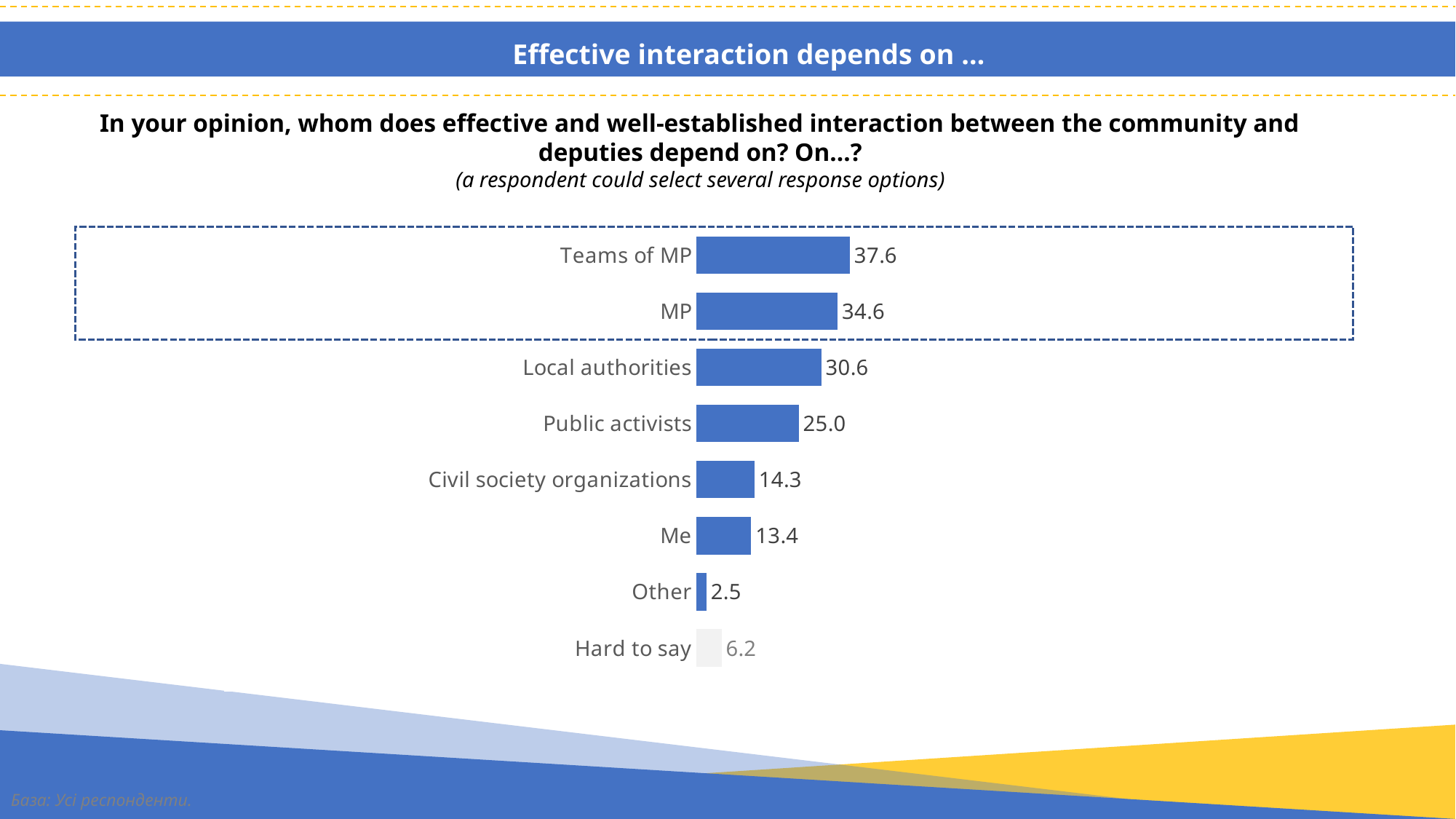
What is the difference between the values for Teams of MP and MP? 3.0 What is the value for Civil society organizations? 14.3 Which category has the highest value? Teams of MP What is the value for Local authorities? 30.6 What is the value for Teams of MP? 37.6 How many categories are shown in the chart? 8 What is the value for Hard to say? 6.2 Which category's bar is drawn in a different (grey) colour from the others? Hard to say Which is larger, the value for Local authorities or the value for Public activists? Local authorities What is the difference between the values for Public activists and Me? 11.6 What kind of chart is shown on the slide? Bar chart Which category has the lowest value? Other